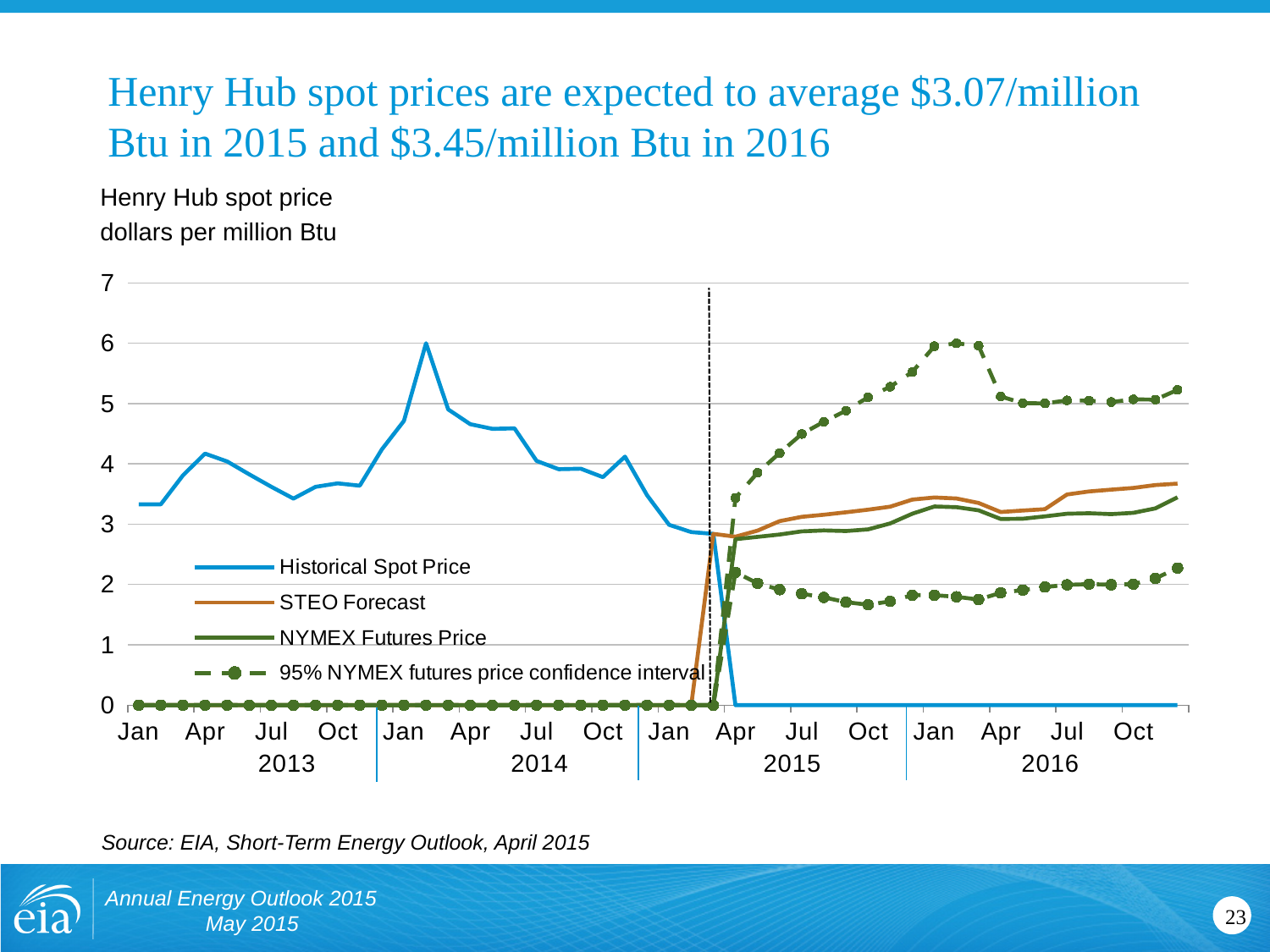
Is the lower 95% NYMEX futures price confidence interval in Oct 2015 greater or less than 2? less Which series in the legend is drawn as a dashed line with markers? 95% NYMEX futures price confidence interval Is the Historical Spot Price in Jan 2013 greater or less than 4? less Does the upper 95% NYMEX futures price confidence interval rise or fall from Apr 2015 to Jan 2016? rise Does the Historical Spot Price rise or fall from Jul 2014 to Jan 2015? fall How many series does the legend list? 4 What unit is the Henry Hub spot price plotted in? dollars per million Btu Is the Historical Spot Price at its early-2014 peak greater or less than 5? greater In Oct 2016, which is higher: the STEO Forecast or the NYMEX Futures Price? STEO Forecast What kind of chart is shown on the slide? Line chart